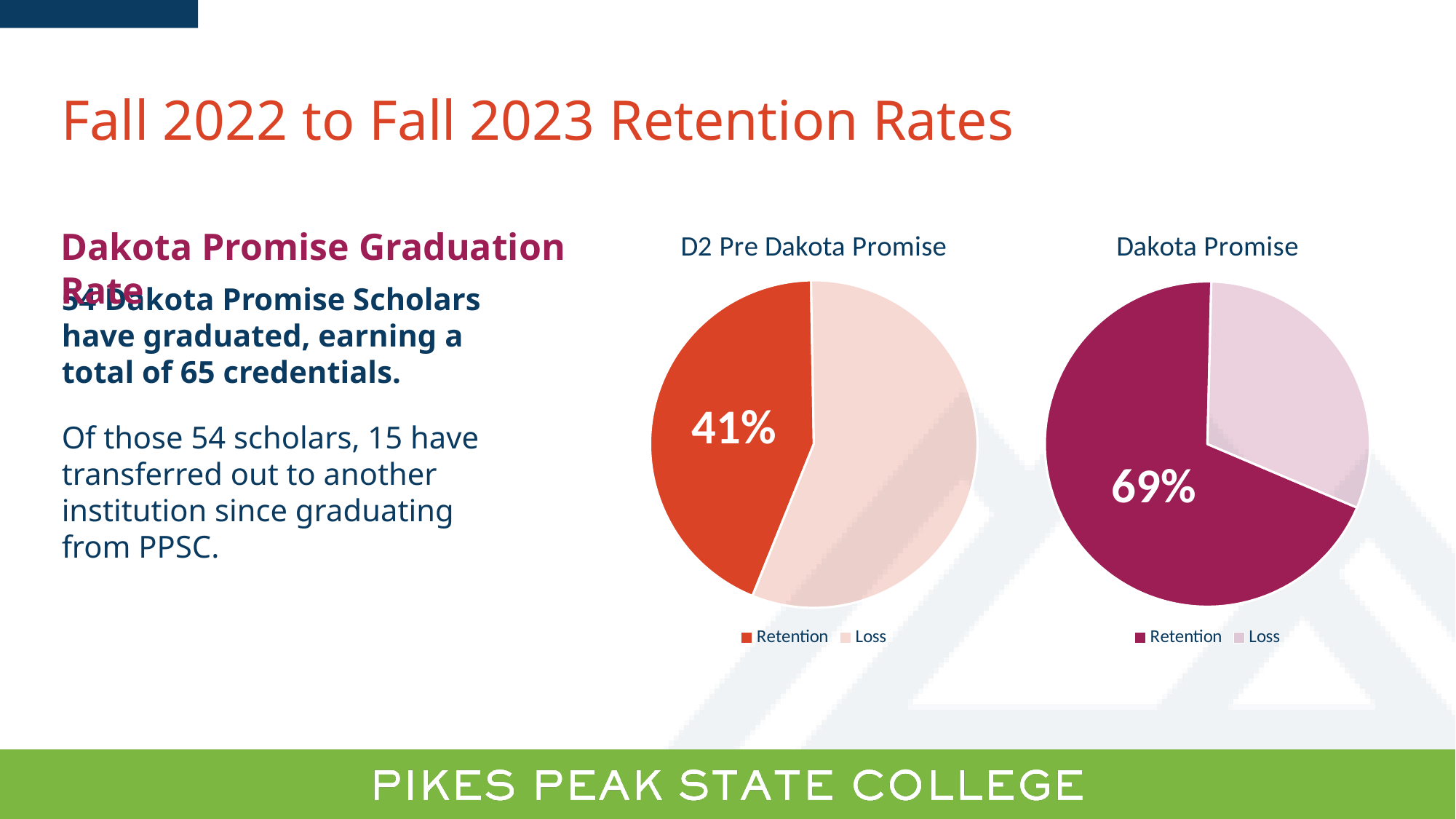
In the Dakota Promise chart, what is the value shown for Retention? 69% What kind of chart is the Dakota Promise chart? Pie chart What kind of chart is the D2 Pre Dakota Promise chart? Pie chart In the Dakota Promise chart, what share of the pie does the Retention slice represent? 69% In the D2 Pre Dakota Promise chart, which slice is larger, Retention or Loss? Loss In the D2 Pre Dakota Promise chart, what is the value shown for Retention? 41% How many entries does the legend of the D2 Pre Dakota Promise chart list? 2 What are the two legend entries shown under the Dakota Promise chart? Retention and Loss What is the difference between the Retention value in the Dakota Promise chart and the Retention value in the D2 Pre Dakota Promise chart? 28 percentage points Which chart shows the higher Retention value, D2 Pre Dakota Promise or Dakota Promise? Dakota Promise In the Dakota Promise chart, which slice is larger, Retention or Loss? Retention How many slices does the Dakota Promise pie chart have? 2